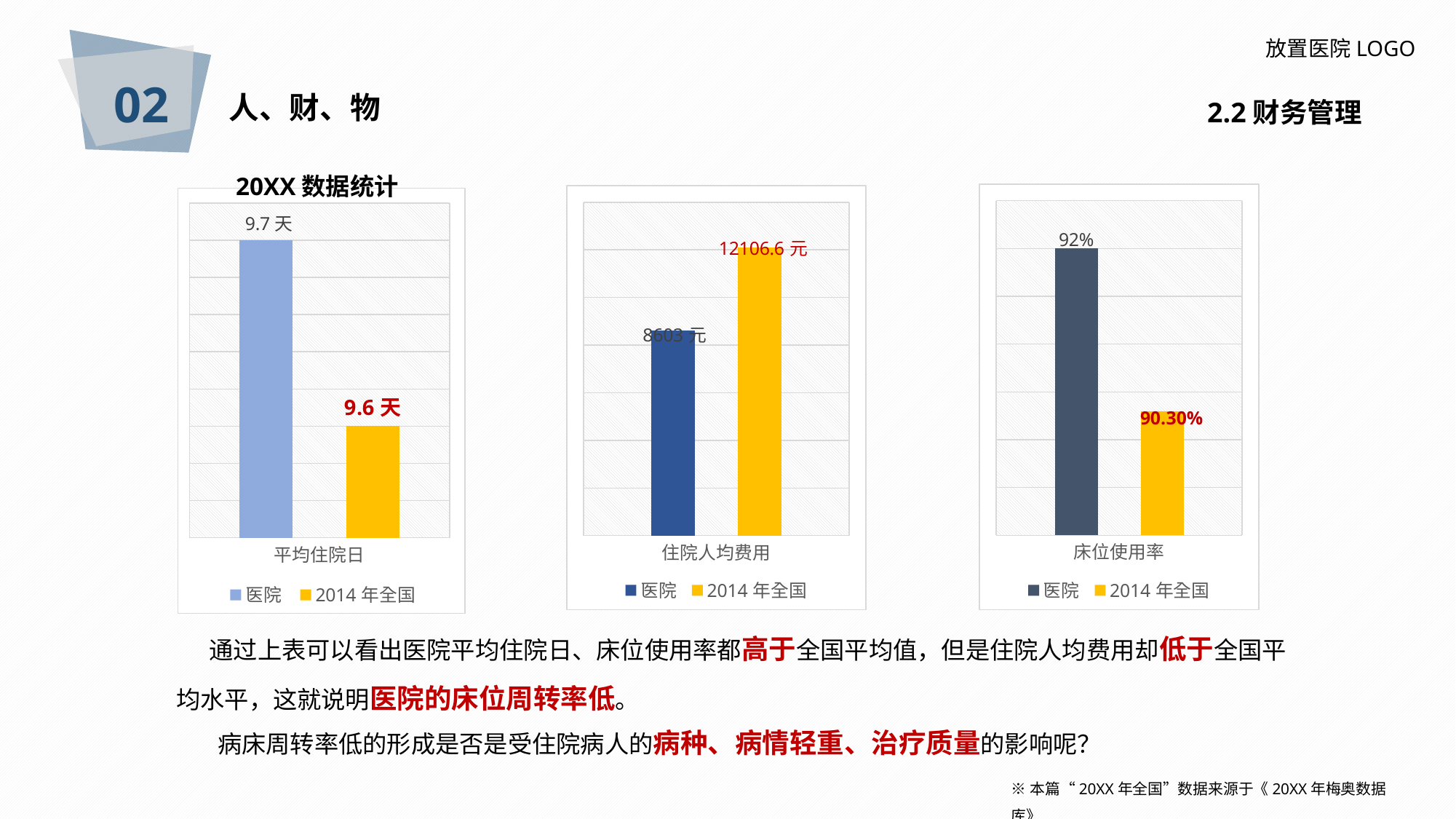
In the middle chart (住院人均费用), what is the value for 医院? 8603 元 What is the title shown above the left chart? 20XX 数据统计 In the left chart (平均住院日), what is the value for 医院? 9.7 天 In the right chart (床位使用率), what is the value for 2014 年全国? 90.30% In the right chart (床位使用率), what is the value for 医院? 92% In the middle chart (住院人均费用), which series has the higher value, 医院 or 2014 年全国? 2014 年全国 What kind of chart is the right chart (床位使用率)? Bar chart In the middle chart (住院人均费用), what is the value for 2014 年全国? 12106.6 元 In the middle chart (住院人均费用), what is the difference between the 2014 年全国 value and the 医院 value? 3503.6 元 In the left chart (平均住院日), what is the value for 2014 年全国? 9.6 天 How many series does the legend of the middle chart (住院人均费用) list? 2 In the right chart (床位使用率), which series has the higher value, 医院 or 2014 年全国? 医院